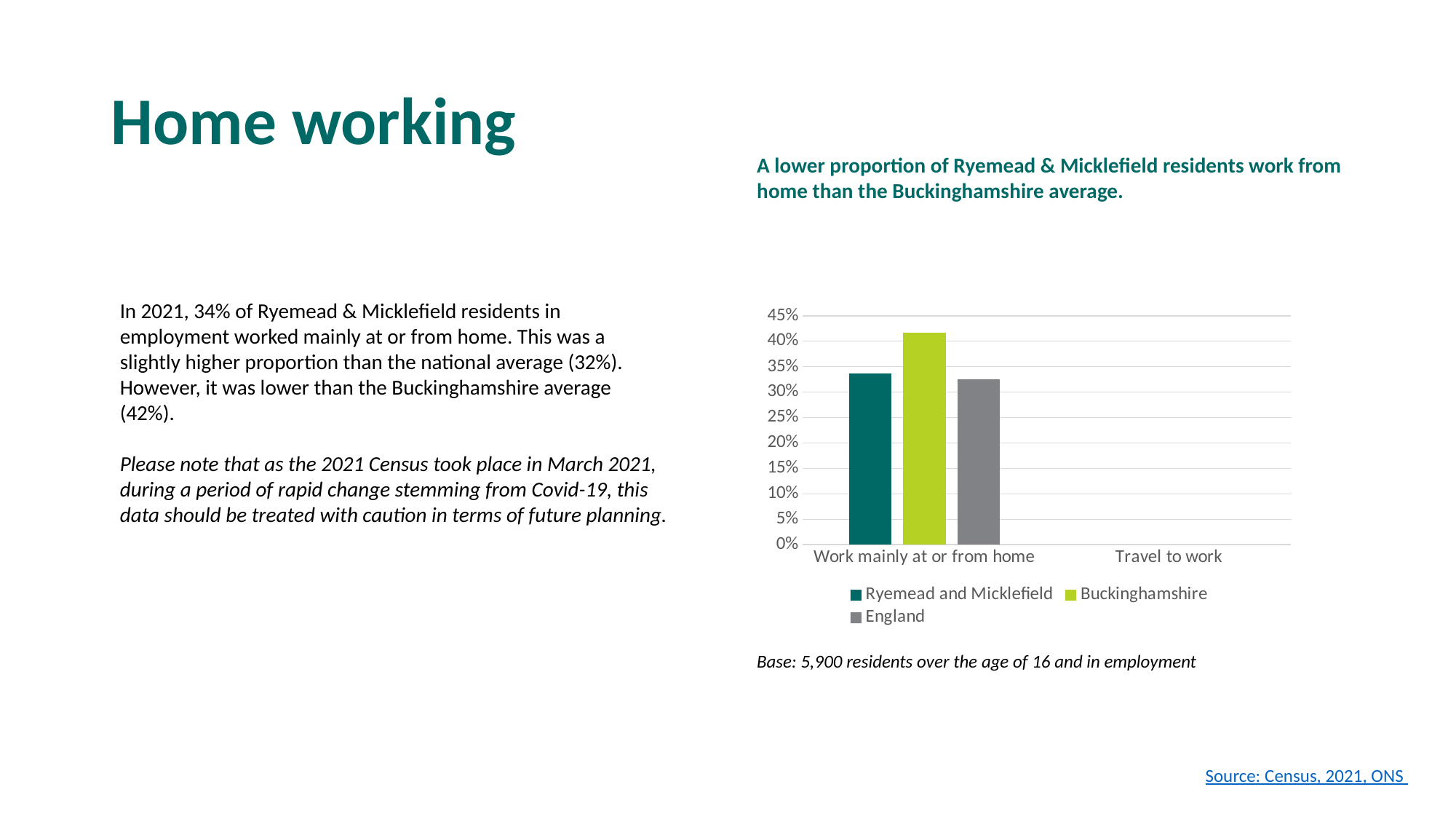
Which series is shown in grey in the chart legend? England Which is larger for 'Work mainly at or from home': Buckinghamshire or England? Buckinghamshire Is the value for England for 'Work mainly at or from home' greater or less than 30%? greater How many series does the chart legend list? 3 How many categories are labelled on the x axis of the chart? 2 Is the value for Ryemead and Micklefield for 'Work mainly at or from home' greater or less than 30%? greater Is the value for Buckinghamshire for 'Work mainly at or from home' greater or less than 40%? greater What is the highest value shown on the chart's y axis? 45% Which series has the highest bar for 'Work mainly at or from home'? Buckinghamshire What kind of chart is shown on the slide? bar chart